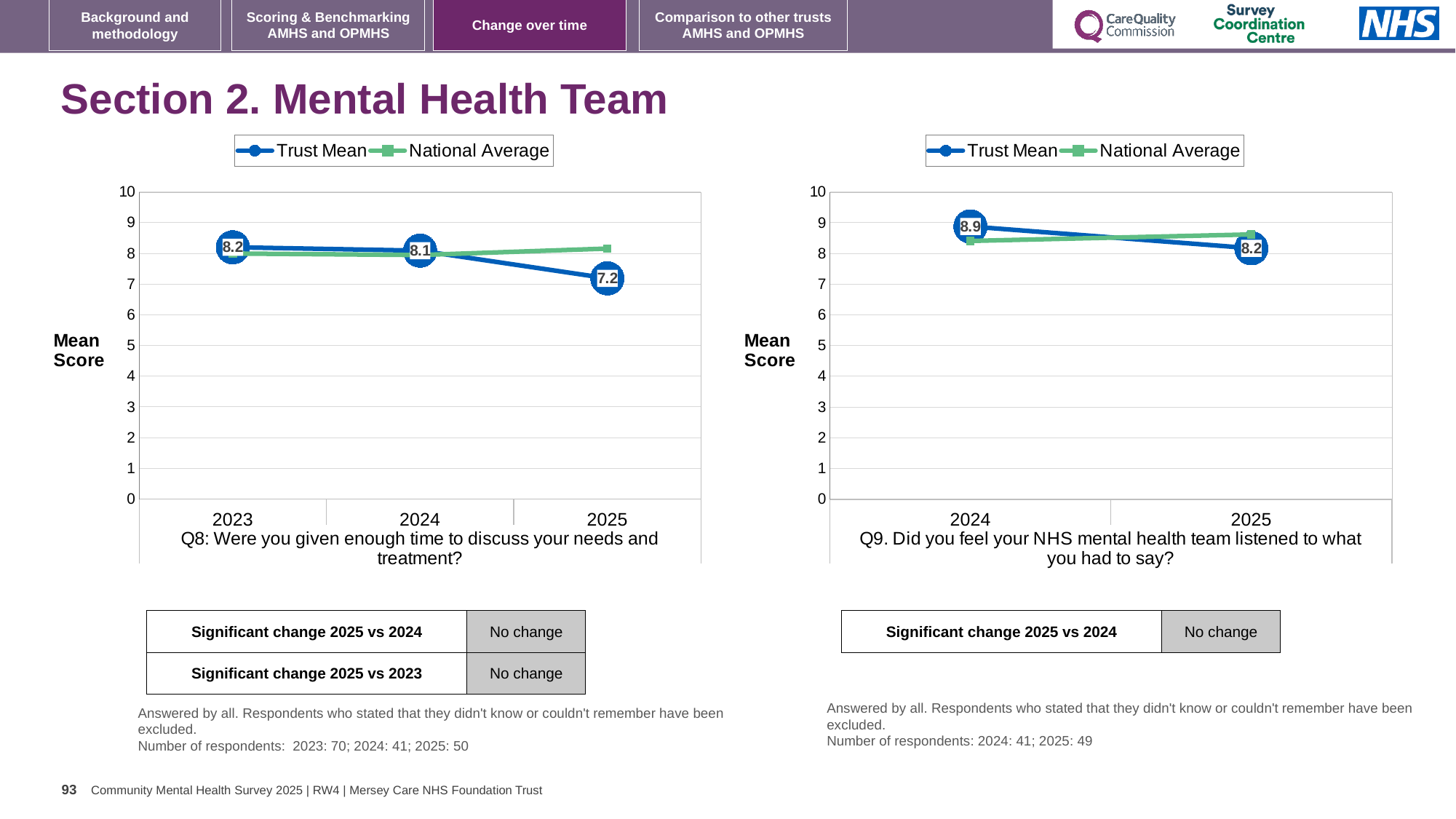
On the Q9 chart (right), is the Trust Mean higher in 2024 or in 2025? 2024 How many series does the legend of the Q9 chart (right) list? 2 On the Q9 chart (right), what is the difference between the Trust Mean in 2024 and in 2025? 0.7 On the Q8 chart (left), what is the Trust Mean for 2025? 7.2 On the Q8 chart (left), which year has the lowest Trust Mean? 2025 On the Q8 chart (left), what is the Trust Mean for 2023? 8.2 How many years are shown on the x axis of the Q8 chart (left)? 3 On the Q8 chart (left), is the National Average for 2025 greater or less than 7? greater On the Q9 chart (right), what is the Trust Mean for 2025? 8.2 On the Q8 chart (left), what is the difference between the Trust Mean in 2023 and in 2025? 1.0 On the Q9 chart (right), what is the Trust Mean for 2024? 8.9 What kind of chart is the Q8 chart (left)? Line chart